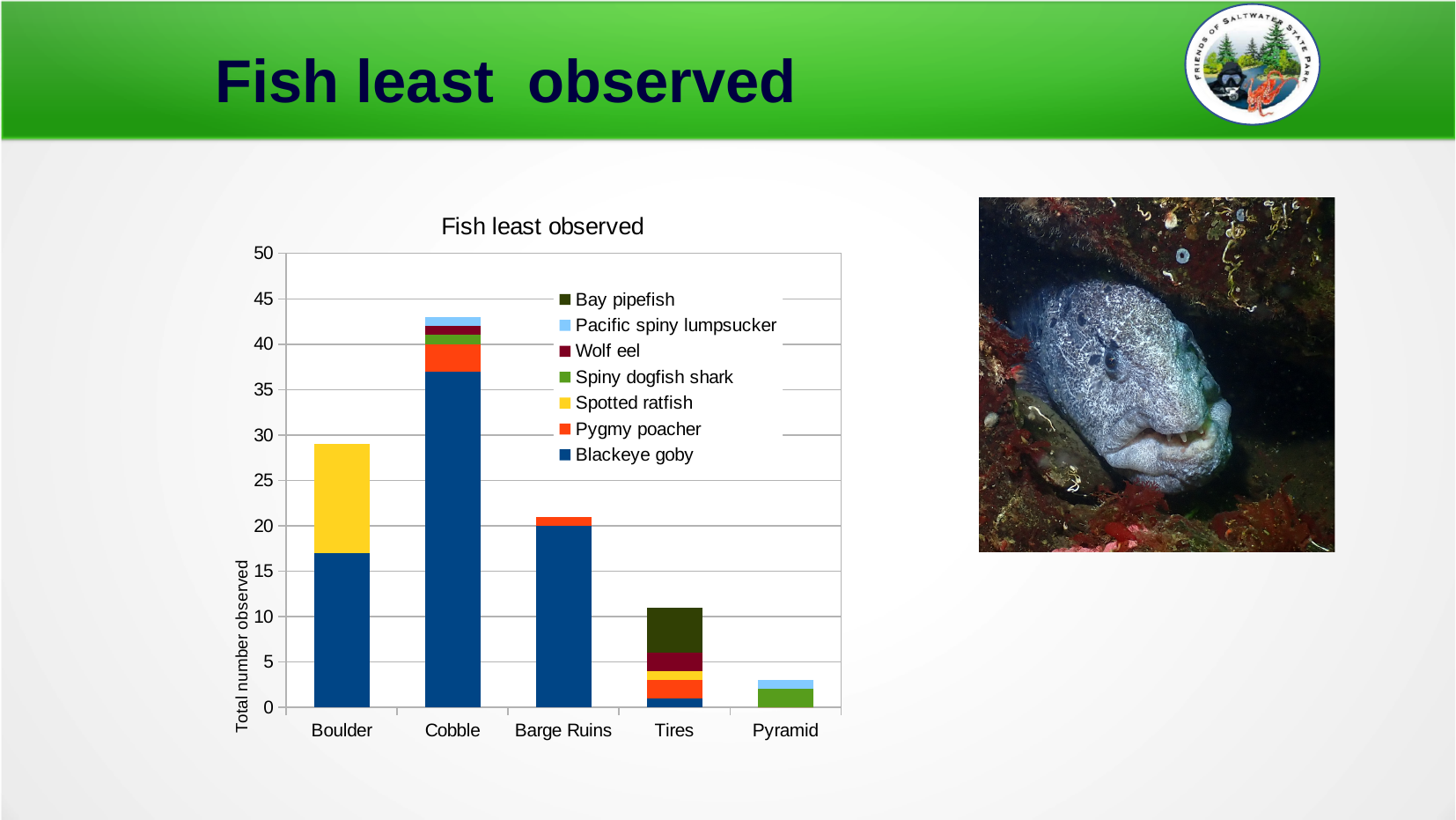
How many series does the chart's legend list? 7 Is the total value for Boulder greater or less than 25? greater What is the label on the vertical axis of the chart? Total number observed What is the title of the chart? Fish least observed What kind of chart is shown on the slide? Stacked bar chart Which has a taller stacked bar, Boulder or Barge Ruins? Boulder Is the total value for Tires greater or less than 15? less Is the total value for Cobble greater or less than 40? greater Which category has the tallest stacked bar in the chart? Cobble How many categories are shown on the x axis of the chart? 5 Which category has the shortest stacked bar in the chart? Pyramid